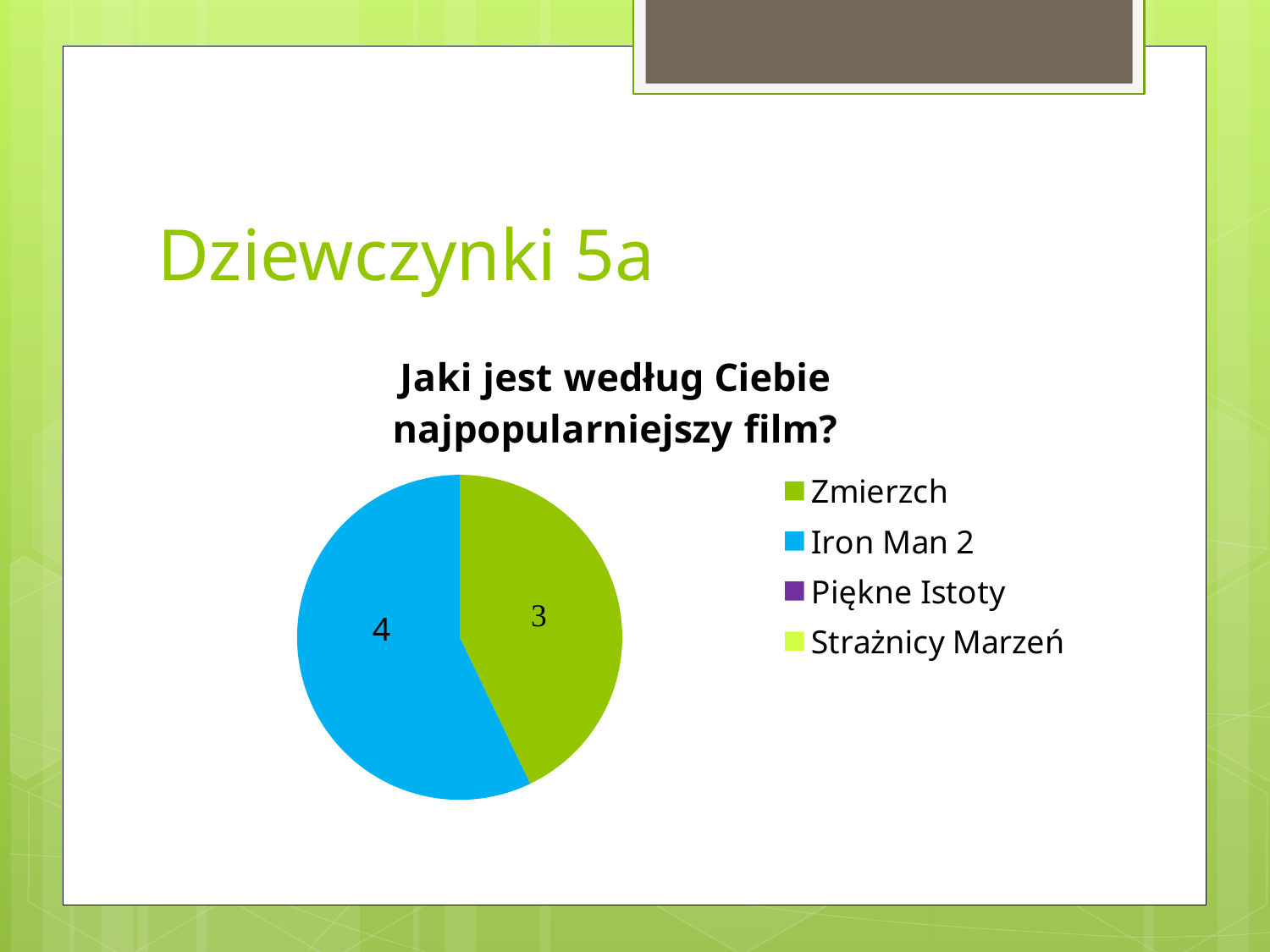
What is the total of the values labelled on the pie chart? 7 What is the value shown for Iron Man 2 in the pie chart? 4 Which is larger, the value for Zmierzch or the value for Iron Man 2? Iron Man 2 What type of chart is shown on the slide? pie chart What is the difference between the value for Iron Man 2 and the value for Zmierzch? 1 What colour is the slice for Iron Man 2 in the pie chart? blue What is the value shown for Zmierzch in the pie chart? 3 What is the title of the pie chart? Jaki jest według Ciebie najpopularniejszy film? How many slices with data labels are visible in the pie chart? 2 How many entries does the legend of the pie chart list? 4 Which film has the largest slice in the pie chart? Iron Man 2